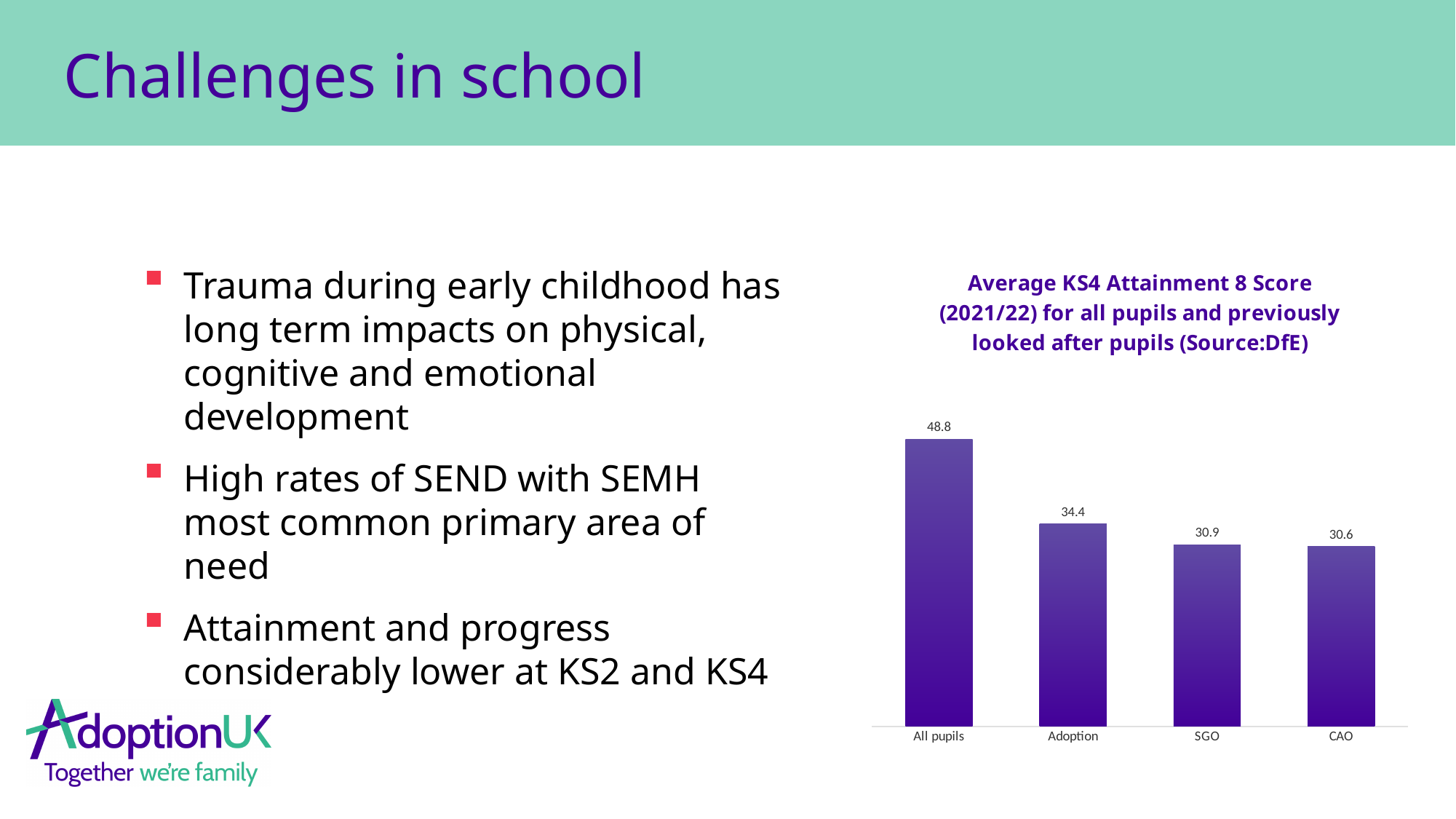
What is the difference between the Attainment 8 Score for All pupils and for the Adoption group? 14.4 What type of chart is shown on the slide? Bar chart What is the Average KS4 Attainment 8 Score for CAO? 30.6 What is the Average KS4 Attainment 8 Score for the Adoption group? 34.4 Which category has the lowest Average KS4 Attainment 8 Score? CAO Which category has the highest Average KS4 Attainment 8 Score? All pupils What is the source of the data cited in the chart title? DfE How many categories are shown in the chart? 4 Which has a higher Attainment 8 Score, Adoption or SGO? Adoption What is the Average KS4 Attainment 8 Score for All pupils? 48.8 What is the Average KS4 Attainment 8 Score for SGO? 30.9 What is the difference between the Attainment 8 Score for SGO and for CAO? 0.3